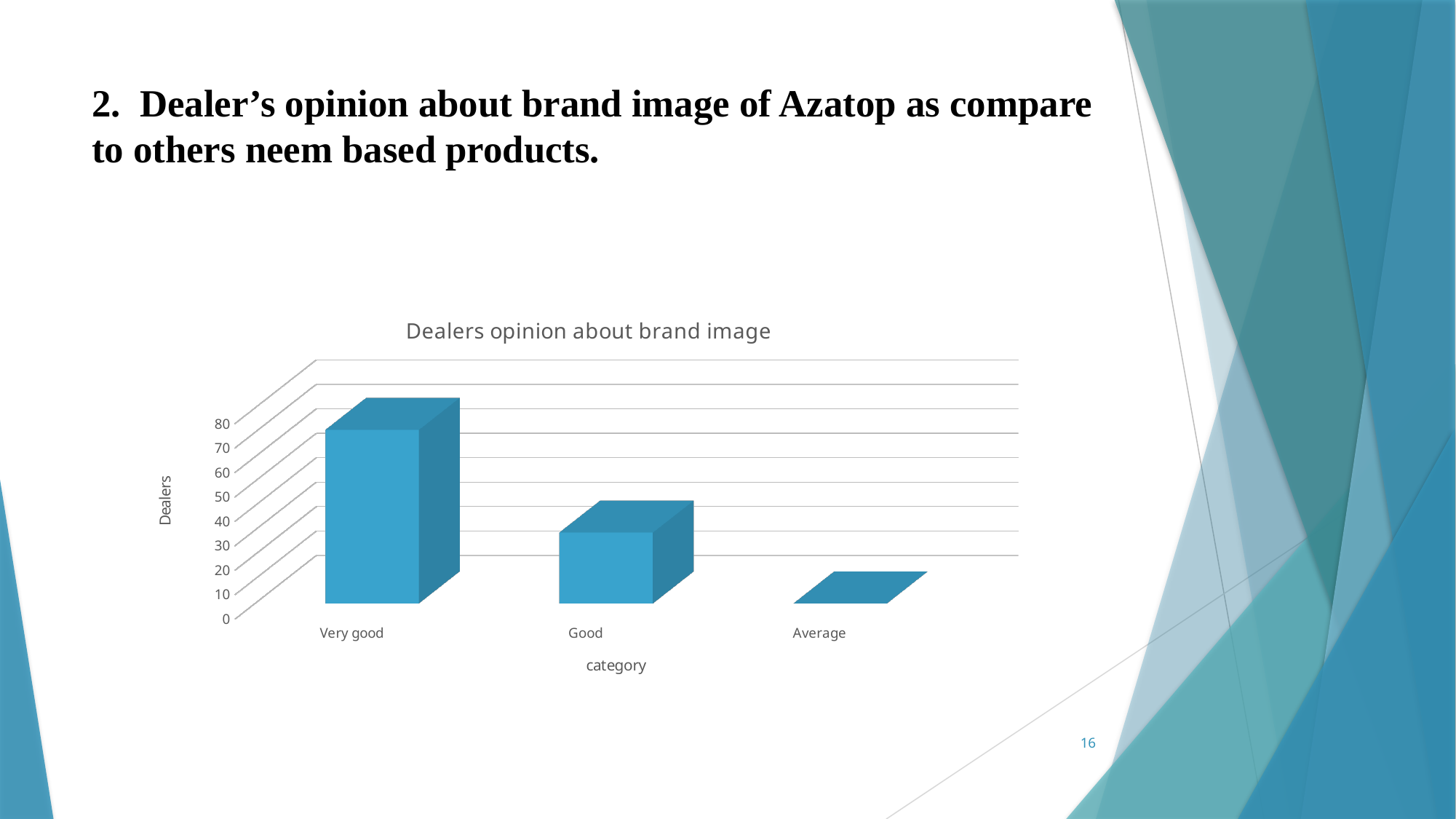
Do the values rise or fall moving from Very good to Average along the x axis? fall How many categories are shown on the x axis of the chart? 3 What is the label of the vertical axis of the chart? Dealers Which category has the highest value in the chart? Very good Is the value for Very good greater or less than 50? greater Is the value for Good greater or less than 50? less What is the title of the chart? Dealers opinion about brand image What kind of chart is shown on the slide? bar chart Which category has the lowest value in the chart? Average Is the value for Average greater or less than 10? less Which is larger, the value for Very good or the value for Good? Very good